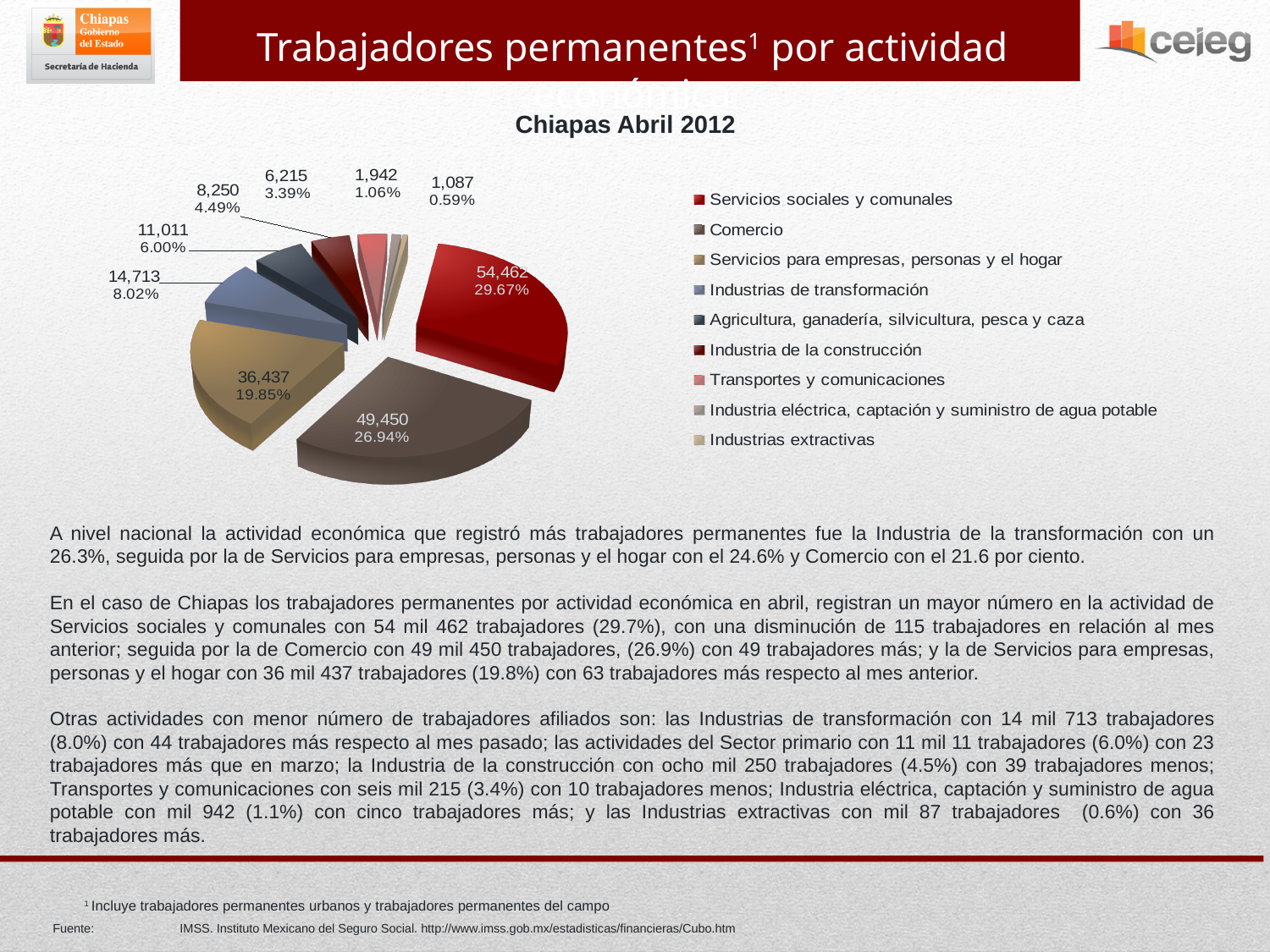
Which category has the smallest slice of the pie? Industrias extractivas What percentage share is shown for Industrias extractivas? 0.59% Which is larger, the value for Agricultura, ganadería, silvicultura, pesca y caza or the value for Industria de la construcción? Agricultura, ganadería, silvicultura, pesca y caza What is the value shown for Comercio? 49,450 What is the value shown for Industrias de transformación? 14,713 What is the difference between the values for Servicios sociales y comunales and Comercio? 5,012 What kind of chart is shown on the slide? Pie chart What percentage share is shown for Servicios para empresas, personas y el hogar? 19.85% What subtitle appears above the pie chart? Chiapas Abril 2012 What is the value shown for Servicios sociales y comunales? 54,462 How many categories does the pie chart legend list? 9 Which category has the largest slice of the pie? Servicios sociales y comunales